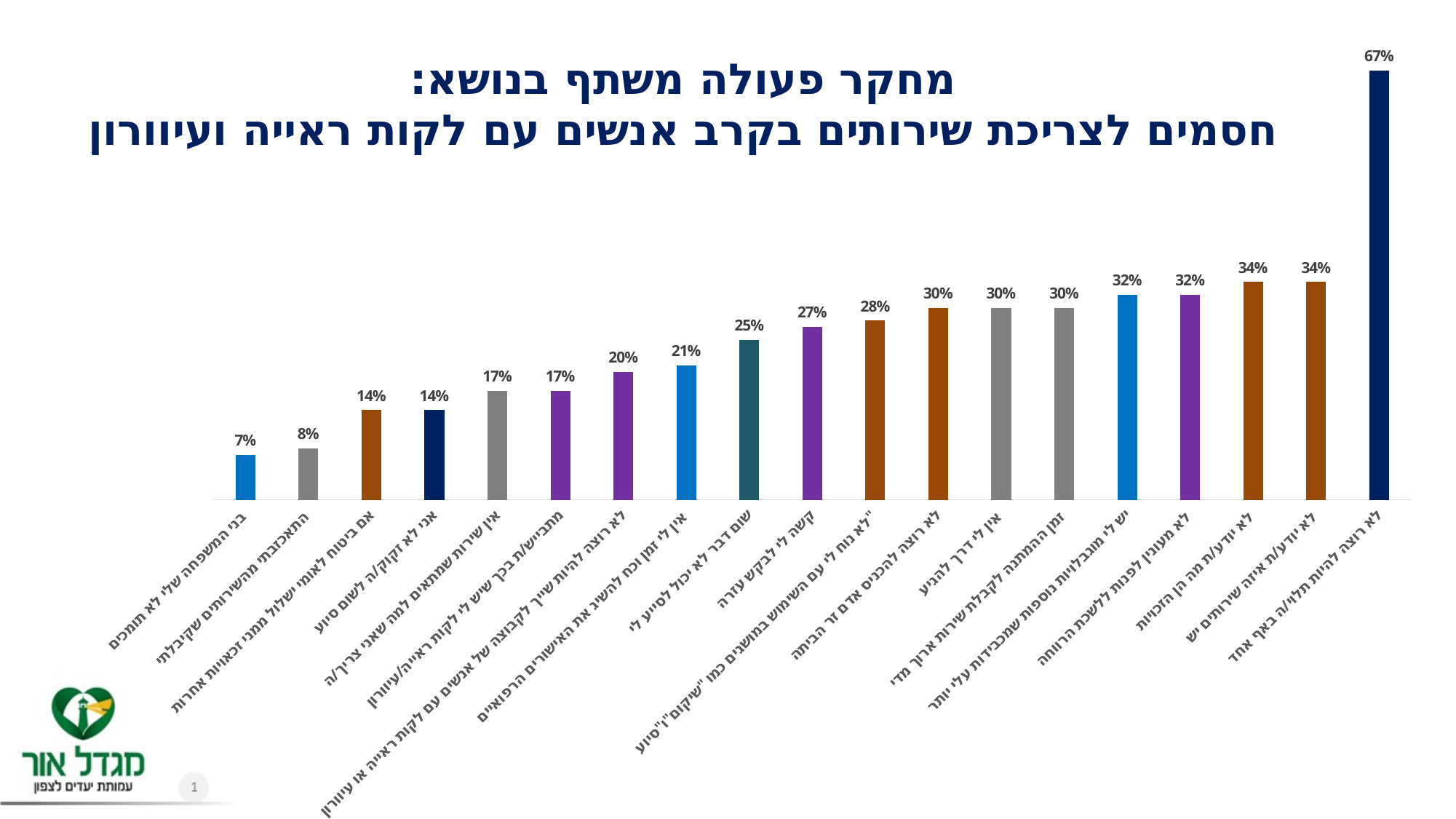
Which is larger: the value for 'שום דבר לא יכול לסייע לי' or the value for 'אין לי זמן וכח להשיג את האישורים הרפואיים'? שום דבר לא יכול לסייע לי What is the difference between the value for 'לא רוצה להיות תלוי/ה באף אחד' and the value for 'לא יודע/ת מה הן הזכויות'? 33% What is the value of the highest bar in the chart? 67% Which category has the lowest value in the chart? בני המשפחה שלי לא תומכים Do the bar values generally rise or fall when reading the chart from left to right? Rise What is the value for 'אין לי דרך להגיע'? 30% What is the value for 'לא יודע/ת איזה שירותים יש'? 34% What kind of chart is shown on the slide? Bar chart What is the value for 'קשה לי לבקש עזרה'? 27% How many bars (categories) does the chart show? 19 Which category has the highest value in the chart? לא רוצה להיות תלוי/ה באף אחד What is the value for 'התאכזבתי מהשירותים שקיבלתי'? 8%